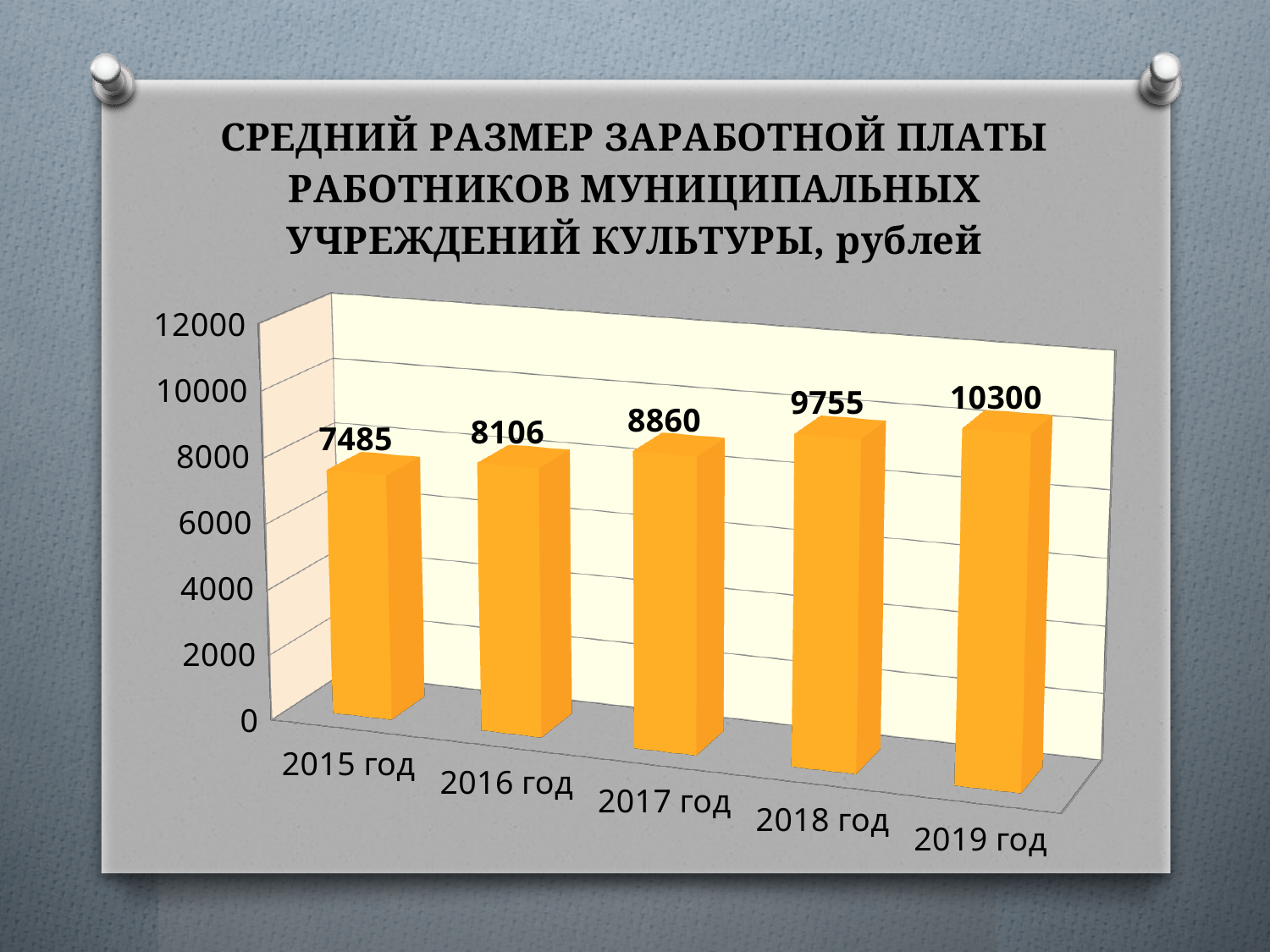
What is the value for 2017 год? 8860 Do the values rise or fall from 2015 год to 2019 год? rise Is the value for 2018 год greater or less than 10000? less What is the value for 2015 год? 7485 How many years are shown on the chart? 5 Which year has the highest value? 2019 год What kind of chart is shown on the slide? bar chart What is the difference between the values for 2019 год and 2018 год? 545 What is the value for 2019 год? 10300 Which is larger, the value for 2016 год or the value for 2018 год? 2018 год What is the difference between the values for 2016 год and 2015 год? 621 Which year has the lowest value? 2015 год